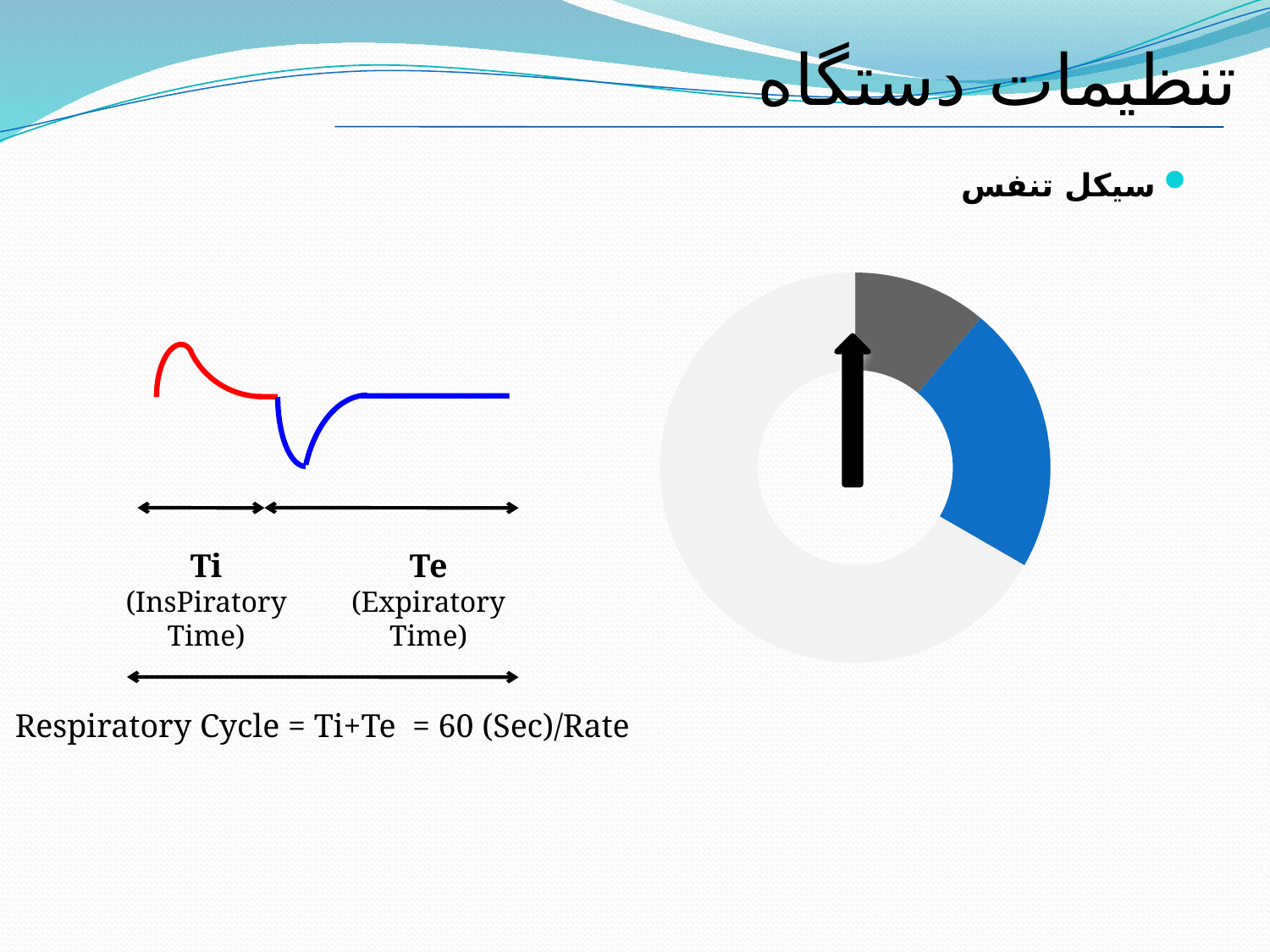
How many segments does the doughnut chart on the right contain? 3 In the doughnut chart on the right, is the blue segment larger or smaller than the dark gray segment? larger Does the doughnut chart on the right display a legend? No What kind of chart is shown on the right side of the slide? doughnut chart Which colour segment of the doughnut chart on the right is the smallest? dark gray Does the doughnut chart on the right show any data labels with values? No Which colour segment of the doughnut chart on the right is the largest? light gray